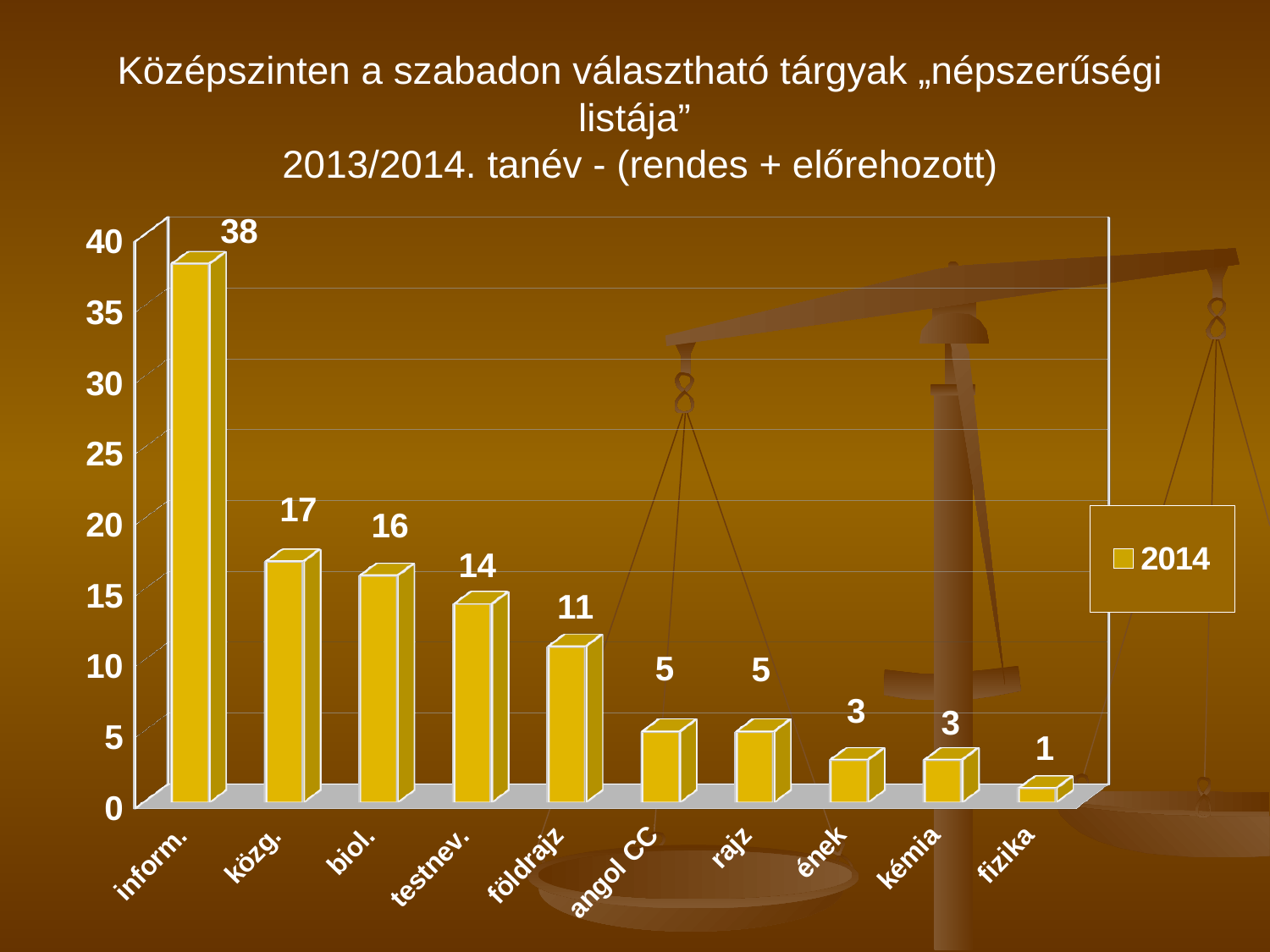
What is the legend entry for the series? 2014 What is the difference between the values for inform. and közg.? 21 How many series does the legend list? 1 Which category has the lowest value? fizika Which is larger, the value for közg. or the value for biol.? közg. What is the value for inform.? 38 What is the difference between the values for biol. and földrajz? 5 What is the value for földrajz? 11 What kind of chart is shown on the slide? bar chart Which category has the highest value? inform. How many categories are shown on the x axis? 10 What is the value for testnev.? 14